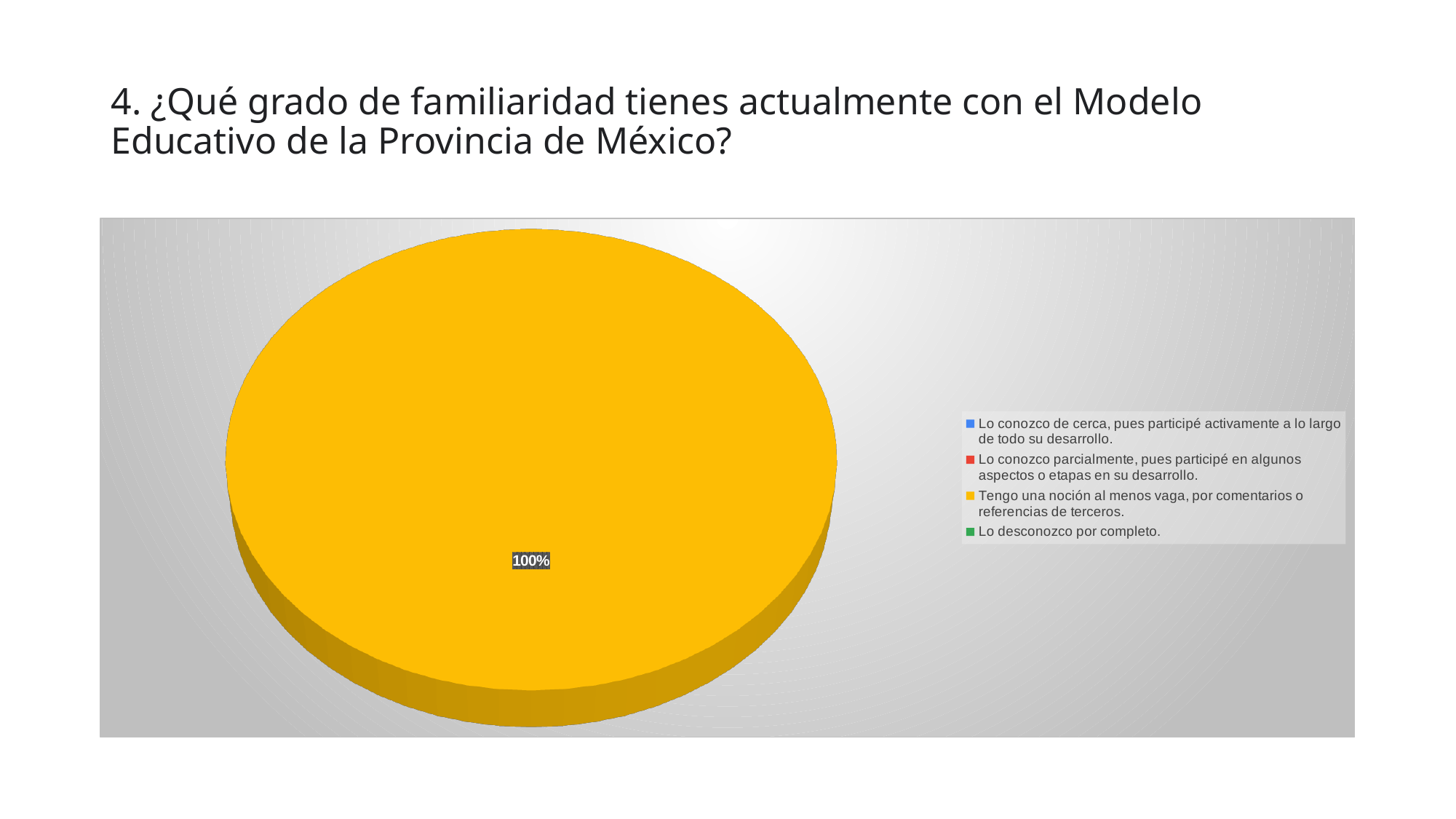
What percentage is shown for the slice "Tengo una noción al menos vaga, por comentarios o referencias de terceros."? 100% Is the value for "Tengo una noción al menos vaga, por comentarios o referencias de terceros." greater or less than 50%? greater Which legend entry is shown in green? Lo desconozco por completo. What share of the pie does the yellow slice represent? 100% Which category has the largest share of the pie? Tengo una noción al menos vaga, por comentarios o referencias de terceros. What colour is the slice labelled 100%? Yellow What kind of chart is shown on the slide? Pie chart How many slices are visible in the pie? 1 How many entries does the legend list? 4